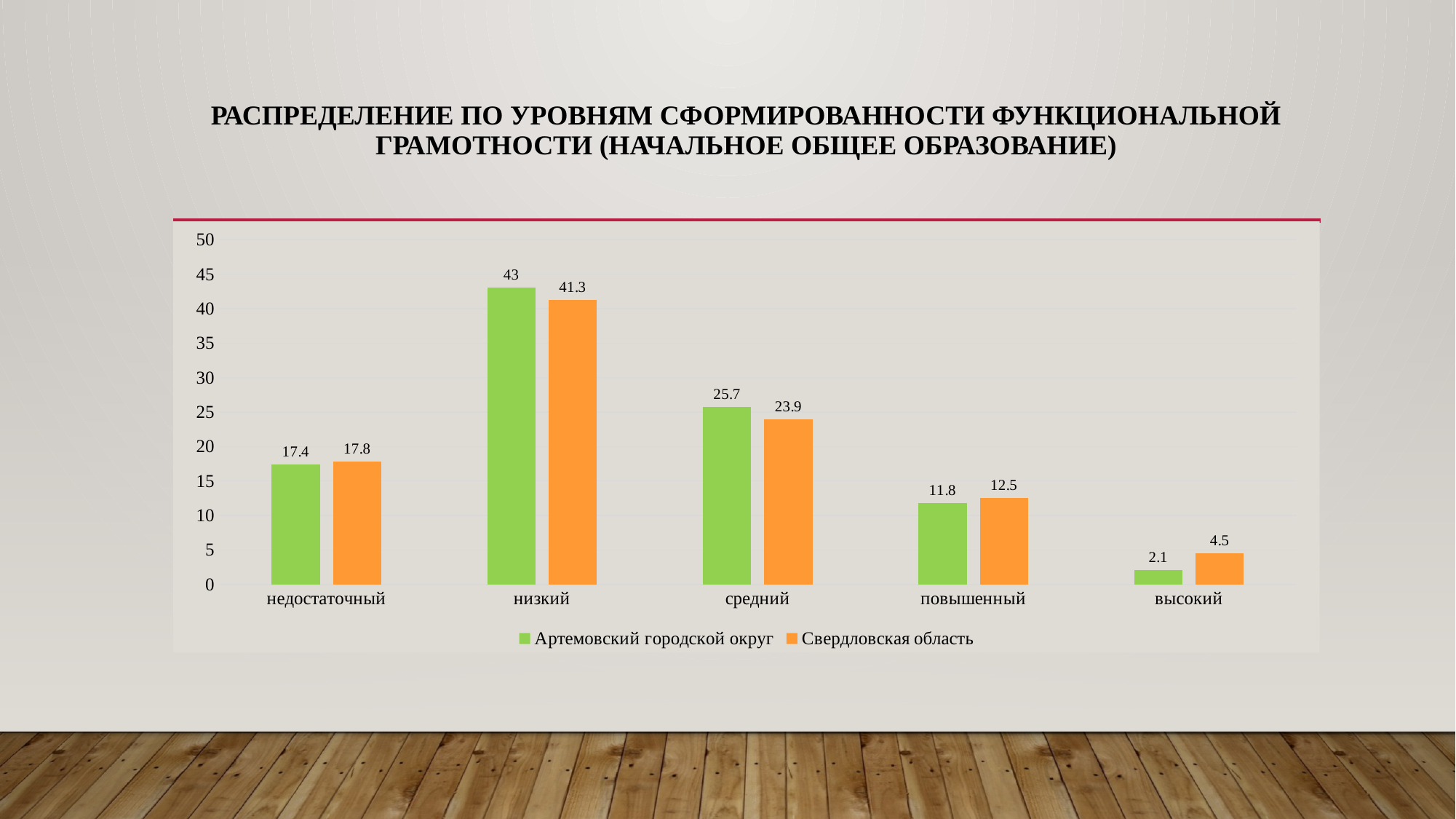
What is the value for Свердловская область at the высокий level? 4.5 Which level has the lowest value for Свердловская область? высокий How many levels (categories) are shown on the x axis? 5 What kind of chart is shown on the slide? bar chart Which is larger at the средний level: Артемовский городской округ or Свердловская область? Артемовский городской округ What is the value for Артемовский городской округ at the низкий level? 43 Which level has the highest value for Артемовский городской округ? низкий Which is larger at the повышенный level: Артемовский городской округ or Свердловская область? Свердловская область What is the value for Свердловская область at the средний level? 23.9 What is the difference between Артемовский городской округ and Свердловская область at the низкий level? 1.7 What is the difference between Свердловская область and Артемовский городской округ at the высокий level? 2.4 How many series does the legend list? 2